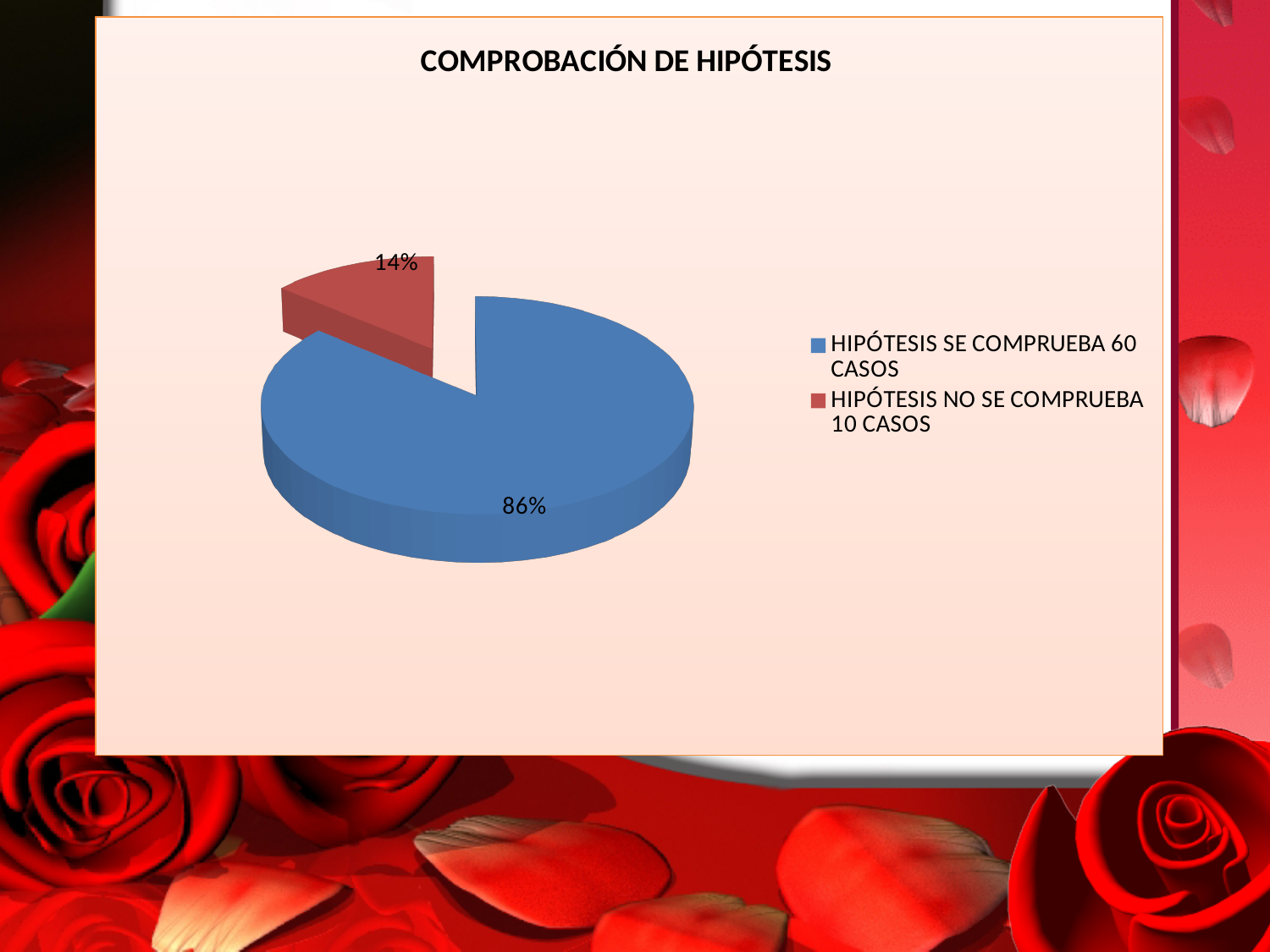
What colour is the slice for 'HIPÓTESIS NO SE COMPRUEBA 10 CASOS'? Red What percentage is shown for the slice 'HIPÓTESIS SE COMPRUEBA 60 CASOS'? 86% What is the difference in percentage points between the 'HIPÓTESIS SE COMPRUEBA' slice and the 'HIPÓTESIS NO SE COMPRUEBA' slice? 72 percentage points What percentage is shown for the slice 'HIPÓTESIS NO SE COMPRUEBA 10 CASOS'? 14% Which slice of the pie is the smallest? HIPÓTESIS NO SE COMPRUEBA 10 CASOS How many slices does the pie chart have? 2 What is the title of the chart? COMPROBACIÓN DE HIPÓTESIS What kind of chart is shown on the slide? Pie chart What share of the pie does the 'HIPÓTESIS SE COMPRUEBA 60 CASOS' slice represent? 86% Which is larger: the 'HIPÓTESIS SE COMPRUEBA' slice or the 'HIPÓTESIS NO SE COMPRUEBA' slice? HIPÓTESIS SE COMPRUEBA 60 CASOS How many entries does the legend list? 2 Which slice of the pie is the largest? HIPÓTESIS SE COMPRUEBA 60 CASOS